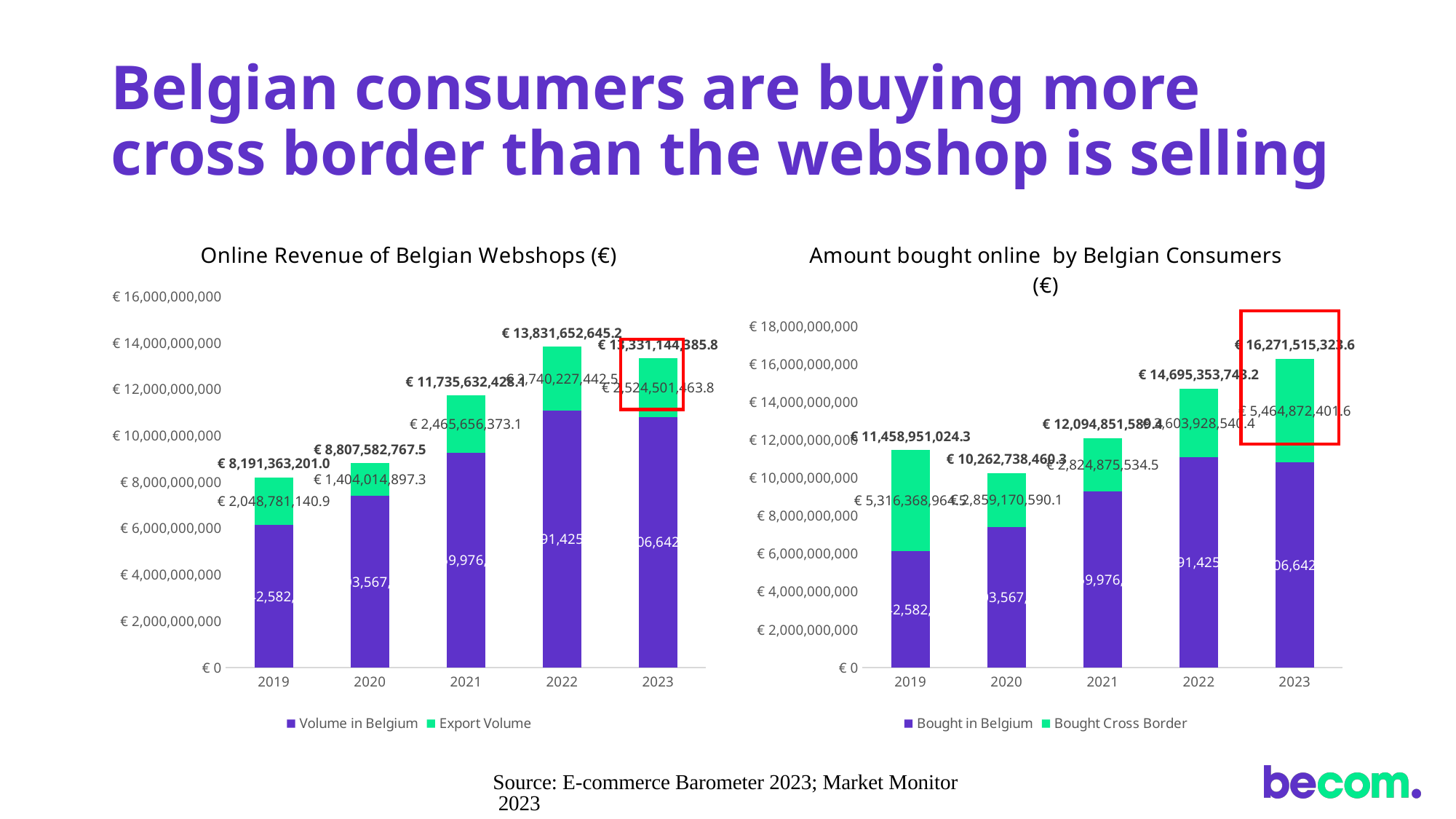
In the 'Online Revenue of Belgian Webshops (€)' chart, what is the Export Volume value for 2023? € 2,524,501,463.8 In the 'Amount bought online by Belgian Consumers (€)' chart, which year has the lowest total? 2020 What kind of chart is the 'Online Revenue of Belgian Webshops (€)' chart? Stacked bar chart In the 'Online Revenue of Belgian Webshops (€)' chart, what is the total value labelled for 2019? € 8,191,363,201.0 In the 'Amount bought online by Belgian Consumers (€)' chart, what is the total value labelled for 2020? € 10,262,738,460.3 In the 'Amount bought online by Belgian Consumers (€)' chart, what is the Bought Cross Border value for 2023? € 5,464,872,401.6 In the 'Online Revenue of Belgian Webshops (€)' chart, what is the Export Volume value for 2020? € 1,404,014,897.3 In the 'Online Revenue of Belgian Webshops (€)' chart, is the total for 2023 greater or less than € 12,000,000,000? greater In the 'Online Revenue of Belgian Webshops (€)' chart, what is the difference between the 2022 total and the 2019 total? € 5,640,289,444.2 In the 'Online Revenue of Belgian Webshops (€)' chart, which year has the highest total? 2022 In the 'Online Revenue of Belgian Webshops (€)' chart, is the Export Volume larger in 2019 or in 2020? 2019 How many series does the legend of the 'Amount bought online by Belgian Consumers (€)' chart list? 2